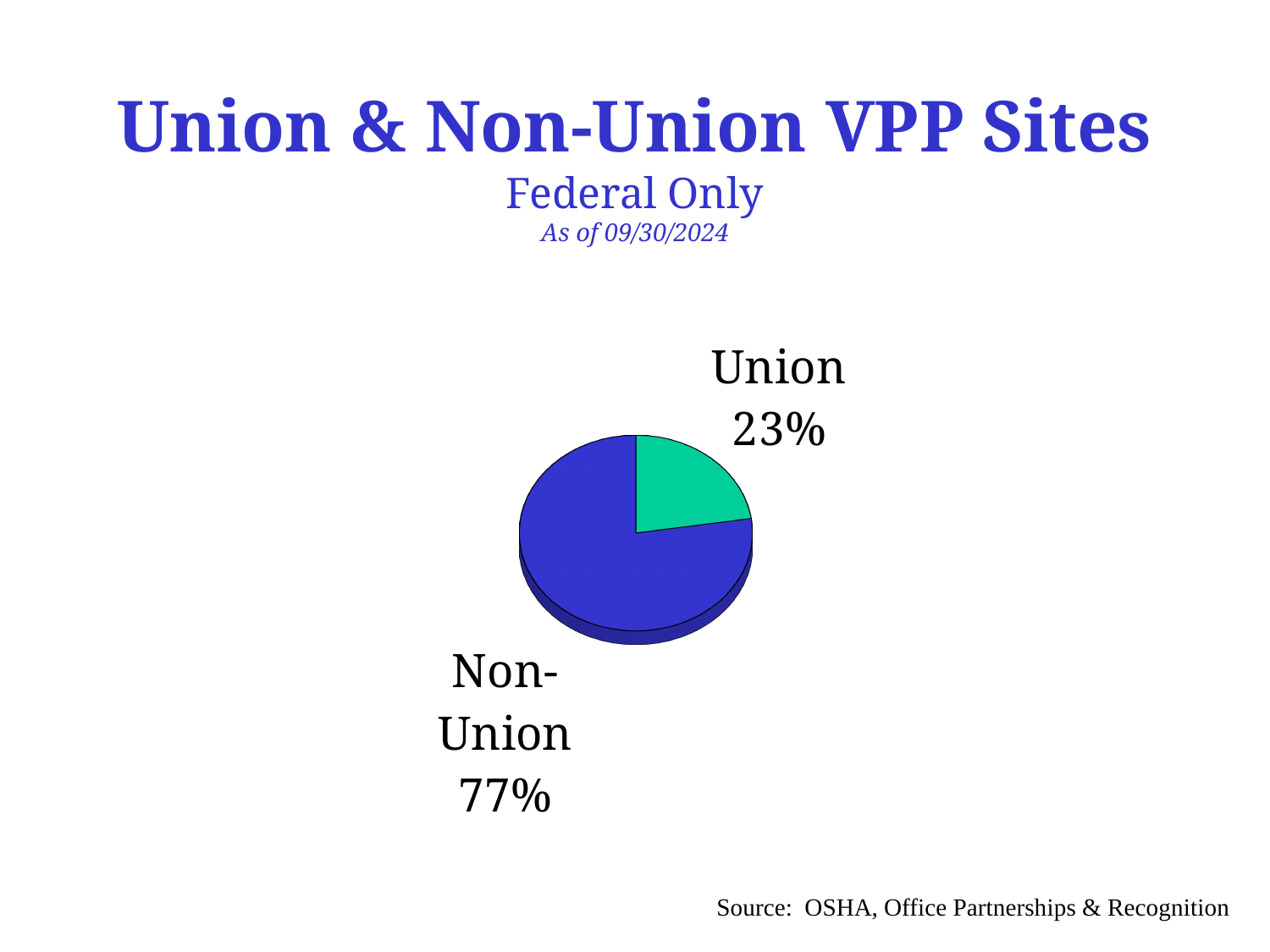
What is the total of the two slices shown? 100% What share of the pie is Non-Union? 77% What colour is the Union slice? green What kind of chart is shown on the slide? pie chart What share of the pie is Union? 23% How many slices does the pie chart have? 2 What is the title of the chart on the slide? Union & Non-Union VPP Sites Which is larger, the Union slice or the Non-Union slice? Non-Union What is the difference in percentage points between Non-Union and Union? 54 Which slice is the largest? Non-Union Which slice is the smallest? Union